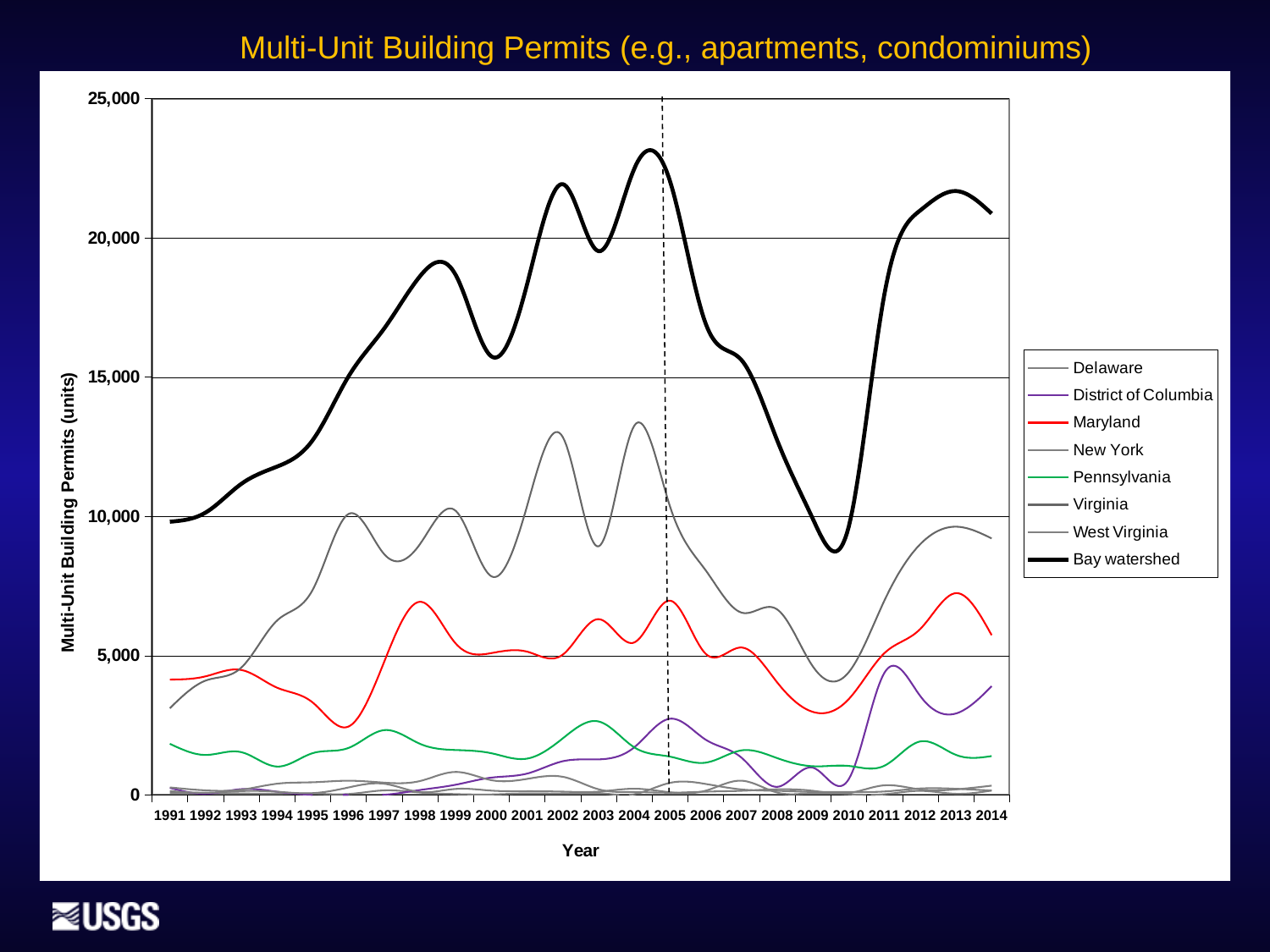
Is the value for New York in 2002 greater or less than 10,000? less Is the value for Bay watershed in 2005 greater or less than 20,000? greater What is the label on the y axis? Multi-Unit Building Permits (units) Which is larger in 2013, the value for Maryland or the value for Pennsylvania? Maryland Does the Bay watershed series rise or fall from 2005 to 2010? fall How many years are shown along the x axis? 24 How many series does the legend list? 8 Is the value for Bay watershed in 2010 greater or less than 10,000? less What kind of chart is shown on the slide? line chart Which series has the highest values across the chart? Bay watershed In which year does the Bay watershed series reach its highest value? 2004